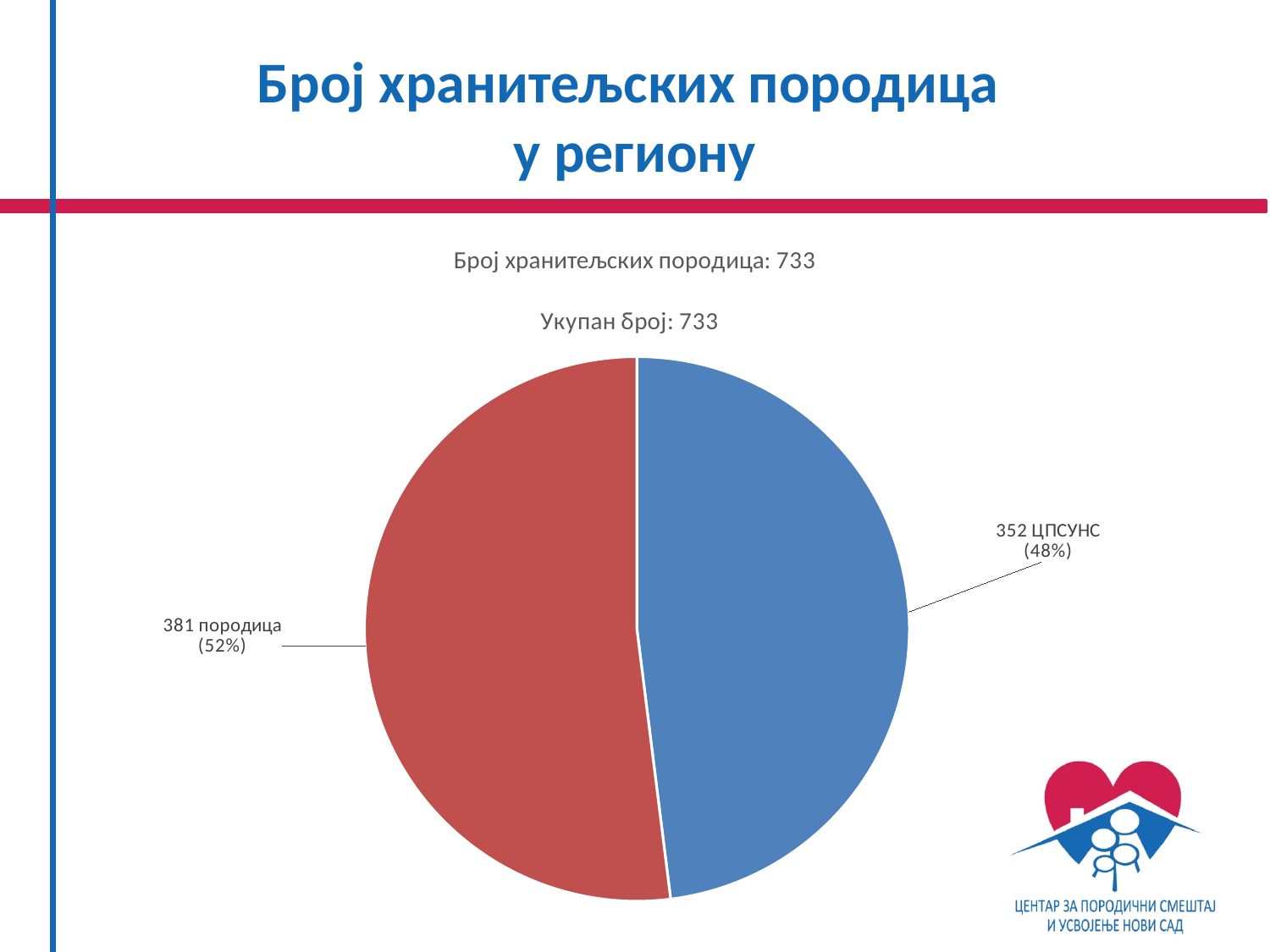
Which slice is the largest in the pie chart? 381 породица (52%) What kind of chart is shown on the slide? pie chart What share of the pie does the "ЦПСУНС" slice represent? 48% What is the difference between the "породица" value and the "ЦПСУНС" value? 29 What total number (Укупан број) is shown above the pie chart? 733 What is the value of the slice labelled "ЦПСУНС"? 352 How many slices does the pie chart have? 2 Which slice is the smallest in the pie chart? 352 ЦПСУНС (48%) What share of the pie does the "породица" slice represent? 52% What is the value of the slice labelled "породица"? 381 Which is larger, the "породица" slice or the "ЦПСУНС" slice? породица What colour is the "ЦПСУНС" slice? blue